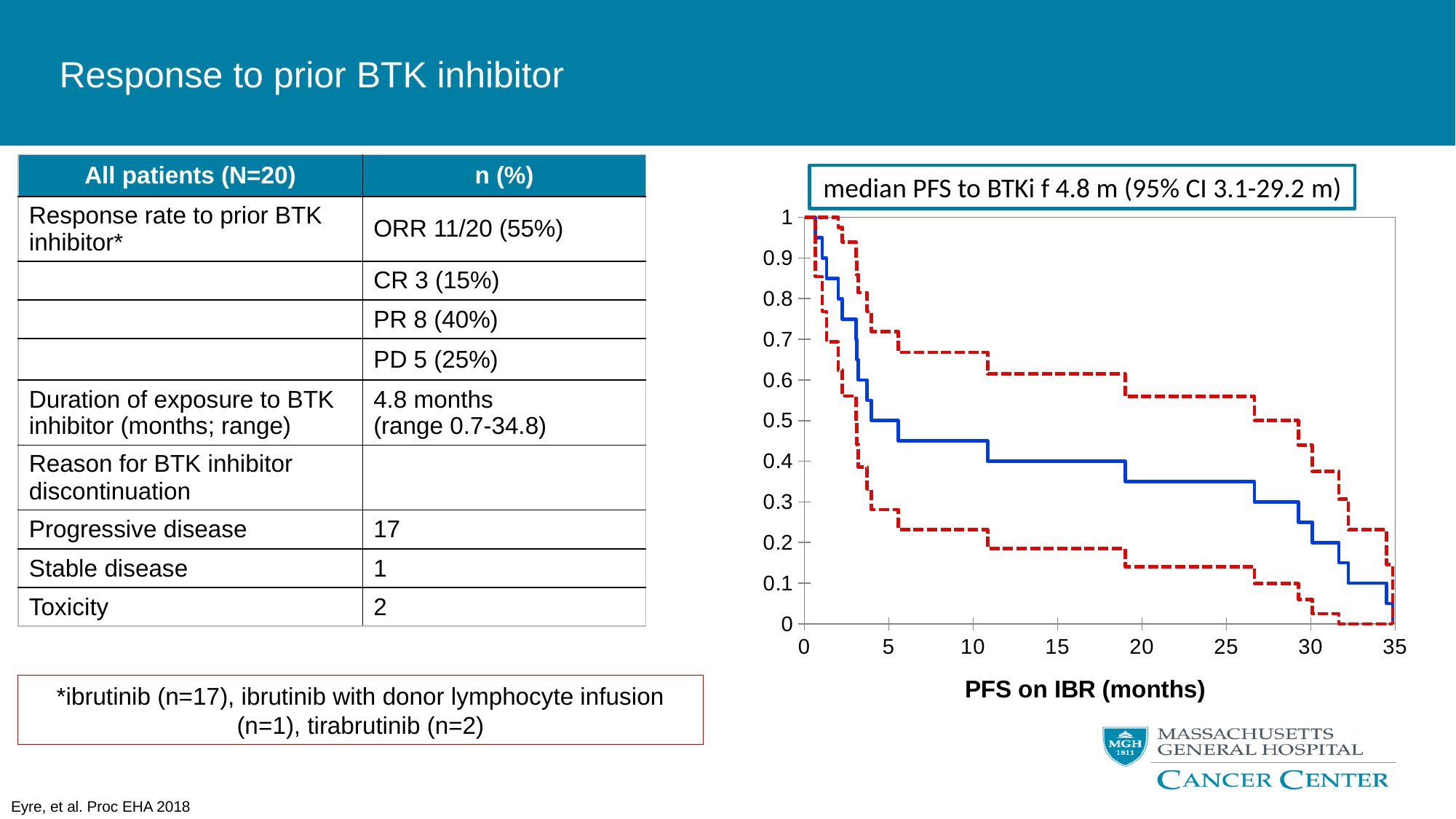
Is the value of the solid blue line at 30 months greater or less than 0.3? less Does the solid blue line rise or fall as months increase along the x axis? Fall What median PFS is stated in the box above the chart? 4.8 m What is the highest tick value shown on the x axis of the chart? 35 Is the value of the solid blue line at 20 months greater or less than 0.5? less What value does the solid blue line reach at 35 months? 0 What kind of chart is shown on the right of the slide? Line chart Is the value of the solid blue line at 25 months greater or less than 0.5? less What is the highest tick value shown on the y axis of the chart? 1 What value does the solid blue line start at when PFS is 0 months? 1 How many lines are plotted on the chart? 3 What is the label of the x axis of the chart? PFS on IBR (months)